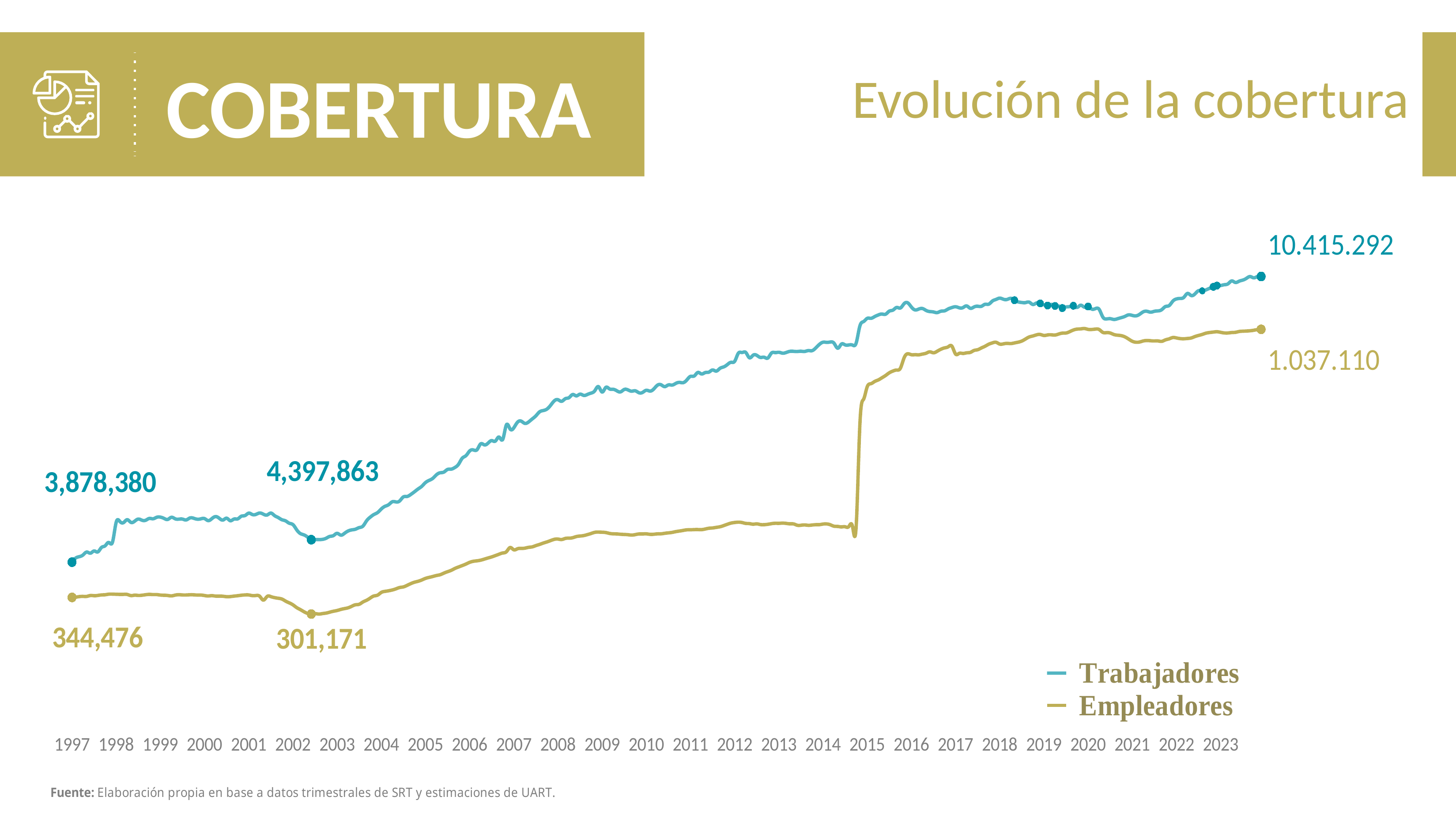
What is the last labelled value of the Trabajadores series, at 2023? 10.415.292 How many series does the legend list? 2 How many years are labelled on the x axis? 27 What is the first labelled value of the Trabajadores series, at 1997? 3,878,380 What is the difference between the 2023 labelled values of Trabajadores and Empleadores? 9.378.182 What are the two series named in the legend? Trabajadores and Empleadores What is the first labelled value of the Empleadores series, at 1997? 344,476 What is the title of the chart? Evolución de la cobertura What is the labelled value of the Empleadores series at its dip around 2002? 301,171 What kind of chart is shown on the slide? line chart What is the last labelled value of the Empleadores series, at 2023? 1.037.110 Which series is higher at 2023, Trabajadores or Empleadores? Trabajadores